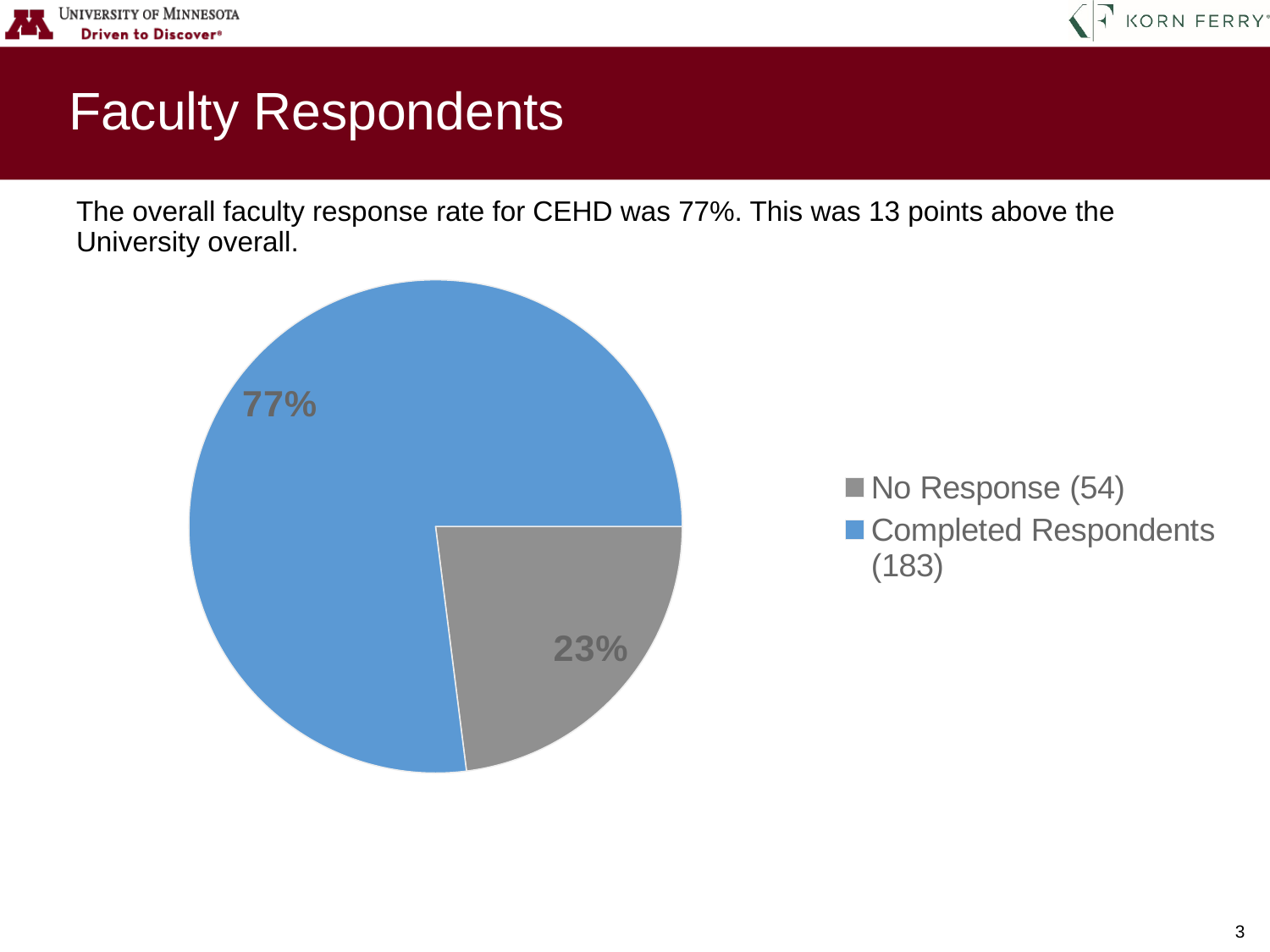
How many entries does the legend list? 2 What count is shown in the legend for No Response? 54 Which slice of the pie is the largest? Completed Respondents How many slices does the pie chart have? 2 What is the difference in percentage points between the Completed Respondents slice and the No Response slice? 54 What percentage of the pie is labelled for No Response? 23% What kind of chart is shown on the slide? pie chart What colour is the Completed Respondents slice? blue What percentage of the pie is labelled for Completed Respondents? 77% Which is larger, the Completed Respondents slice or the No Response slice? Completed Respondents Which slice of the pie is the smallest? No Response What count is shown in the legend for Completed Respondents? 183